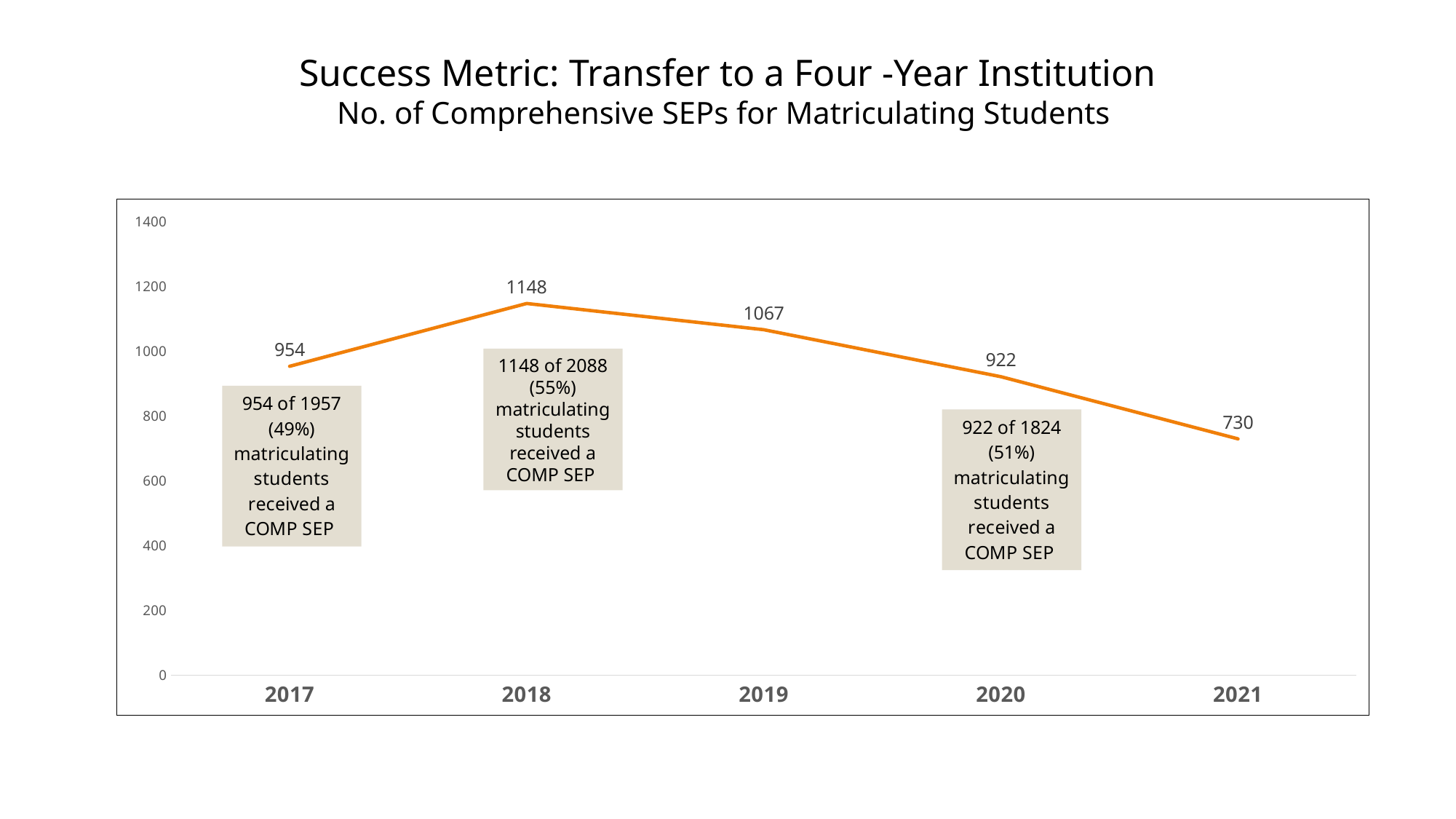
Which year has the highest number of comprehensive SEPs? 2018 What kind of chart is shown on the slide? Line chart Do the values rise or fall from 2018 to 2021? Fall According to the annotation box, what percentage of matriculating students received a COMP SEP in 2018? 55% What is the number of comprehensive SEPs for matriculating students in 2018? 1148 What is the number of comprehensive SEPs for matriculating students in 2017? 954 What is the difference between the number of comprehensive SEPs in 2018 and in 2021? 418 What is the number of comprehensive SEPs for matriculating students in 2021? 730 How many years are plotted on the chart? 5 Which year has more comprehensive SEPs, 2017 or 2020? 2017 What is the number of comprehensive SEPs for matriculating students in 2019? 1067 Which year has the lowest number of comprehensive SEPs? 2021